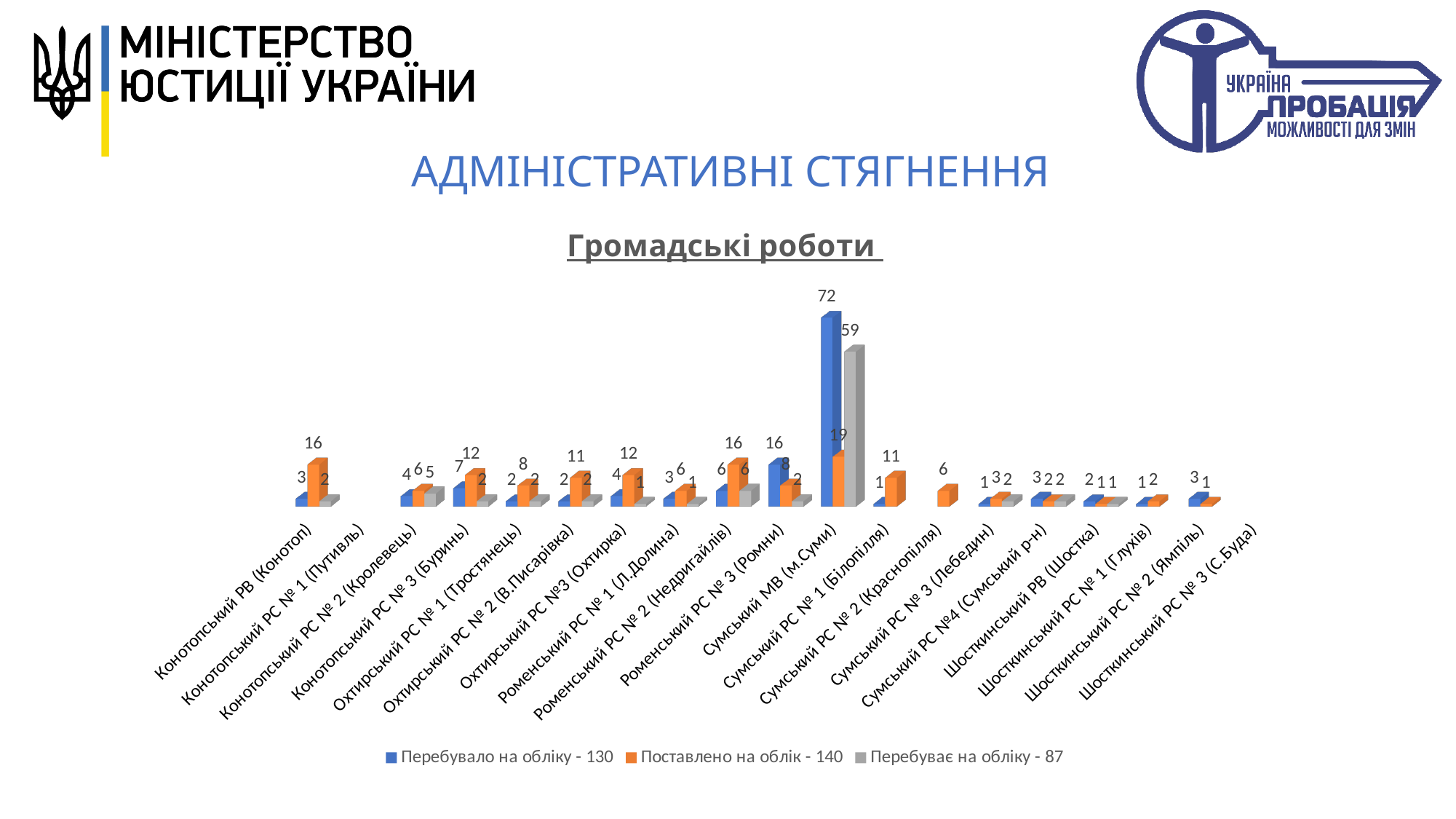
What type of chart is shown on the slide? bar chart What is the value of 'Перебуває на обліку' for Сумський МВ (м.Суми)? 59 What is the value of 'Поставлено на облік' for Конотопський РВ (Конотоп)? 16 Which is larger for Сумський МВ (м.Суми): 'Перебувало на обліку' or 'Поставлено на облік'? Перебувало на обліку What total does the legend give for the series 'Поставлено на облік'? 140 What is the value of 'Перебувало на обліку' for Сумський МВ (м.Суми)? 72 How many series does the legend list? 3 What is the difference between 'Перебувало на обліку' and 'Перебуває на обліку' for Сумський МВ (м.Суми)? 13 What is the title of the chart? Громадські роботи What is the value of 'Перебувало на обліку' for Роменський РС № 3 (Ромни)? 16 Which category has the highest value for 'Перебувало на обліку'? Сумський МВ (м.Суми) What is the value of 'Поставлено на облік' for Сумський МВ (м.Суми)? 19